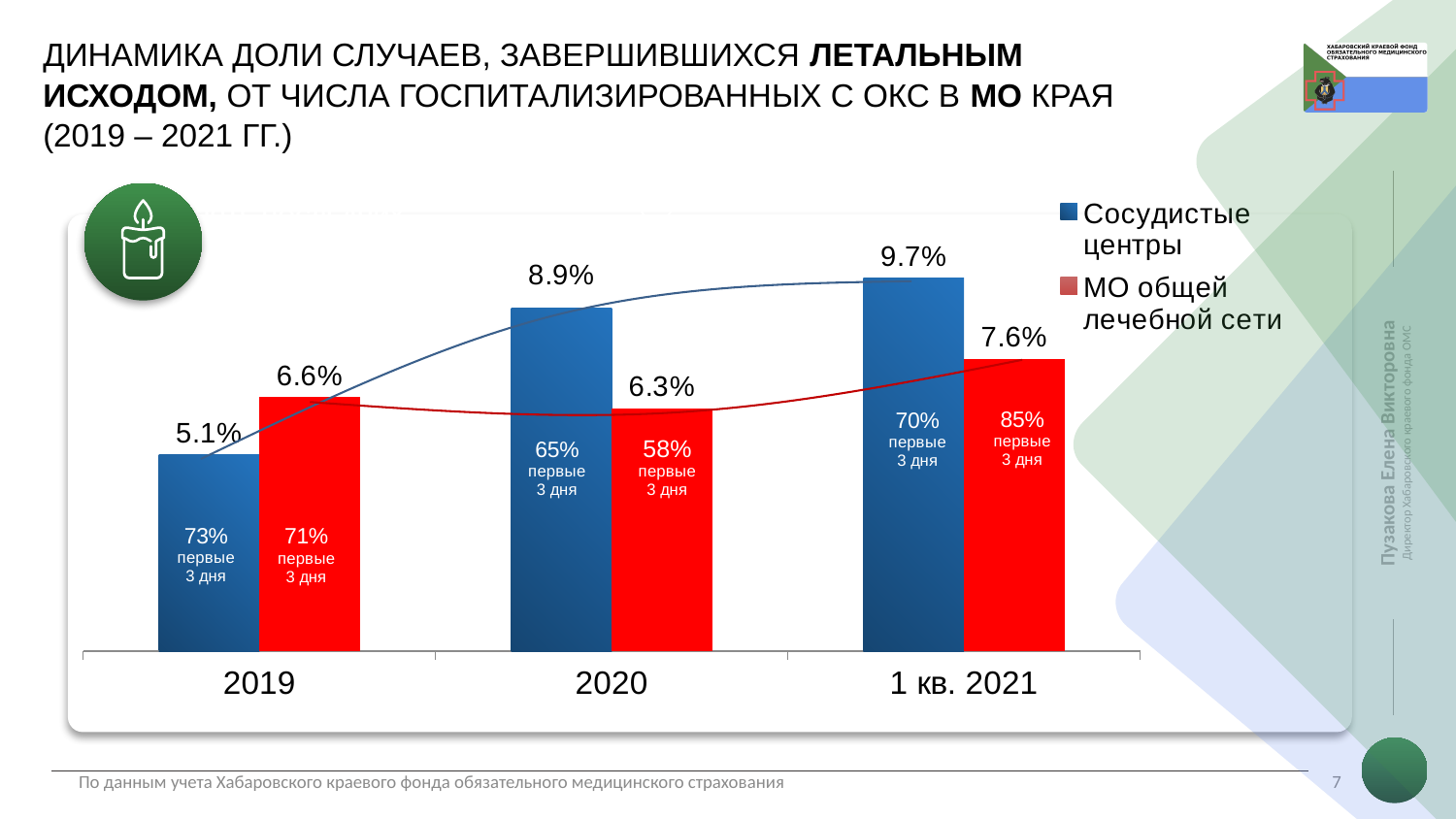
In which period is the value for Сосудистые центры highest? 1 кв. 2021 Which series has the larger value in 2019, Сосудистые центры or МО общей лечебной сети? МО общей лечебной сети What is the difference between the Сосудистые центры and МО общей лечебной сети values in 2020? 2.6% What kind of chart is shown on the slide? Bar chart What is the value for МО общей лечебной сети in 2020? 6.3% What is the value for МО общей лечебной сети in 1 кв. 2021? 7.6% What is the value for Сосудистые центры in 1 кв. 2021? 9.7% Do the values for Сосудистые центры rise or fall from 2019 to 1 кв. 2021? Rise In which period is the value for МО общей лечебной сети lowest? 2020 What is the value for Сосудистые центры in 2019? 5.1% How many periods are shown on the x axis? 3 How many series does the legend list? 2